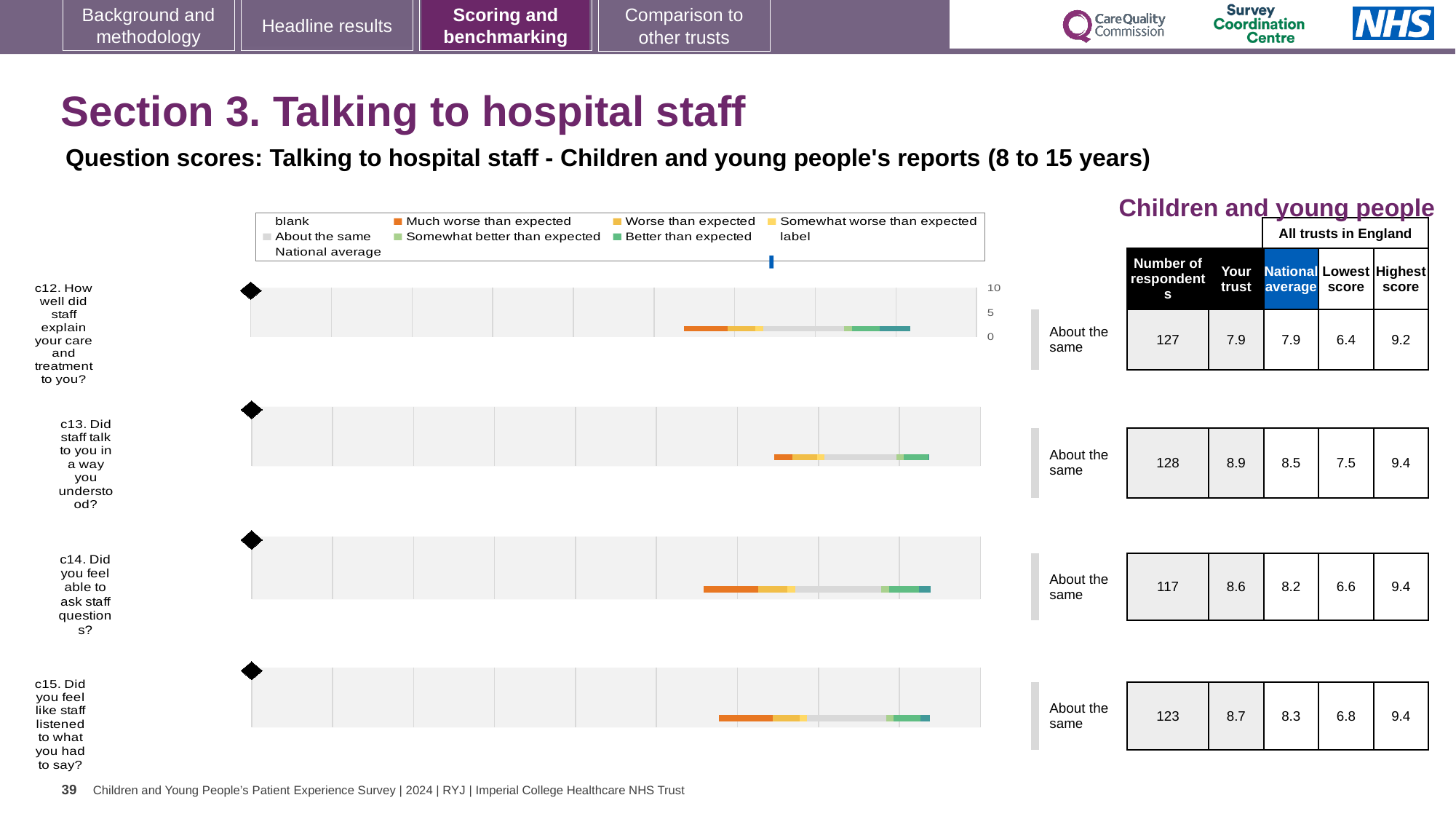
What is the lowest score among all trusts in England for c12? 6.4 What benchmark label is shown next to the c12 chart? About the same What is the national average score for c15 (Did you feel like staff listened to what you had to say)? 8.3 Which question has the lowest 'Your trust' score? c12 Which question has the highest 'Your trust' score? c13 For c14, how much higher is the 'Your trust' score than the national average? 0.4 What is the highest score among all trusts in England for c13? 9.4 What kind of chart is used for the c12 to c15 question scores? bar chart How many respondents answered c14 (Did you feel able to ask staff questions)? 117 How many survey questions (c12 to c15) are charted on the slide? 4 Which has the higher 'Your trust' score, c13 or c15? c13 What is the 'Your trust' score for c13 (Did staff talk to you in a way you understood)? 8.9